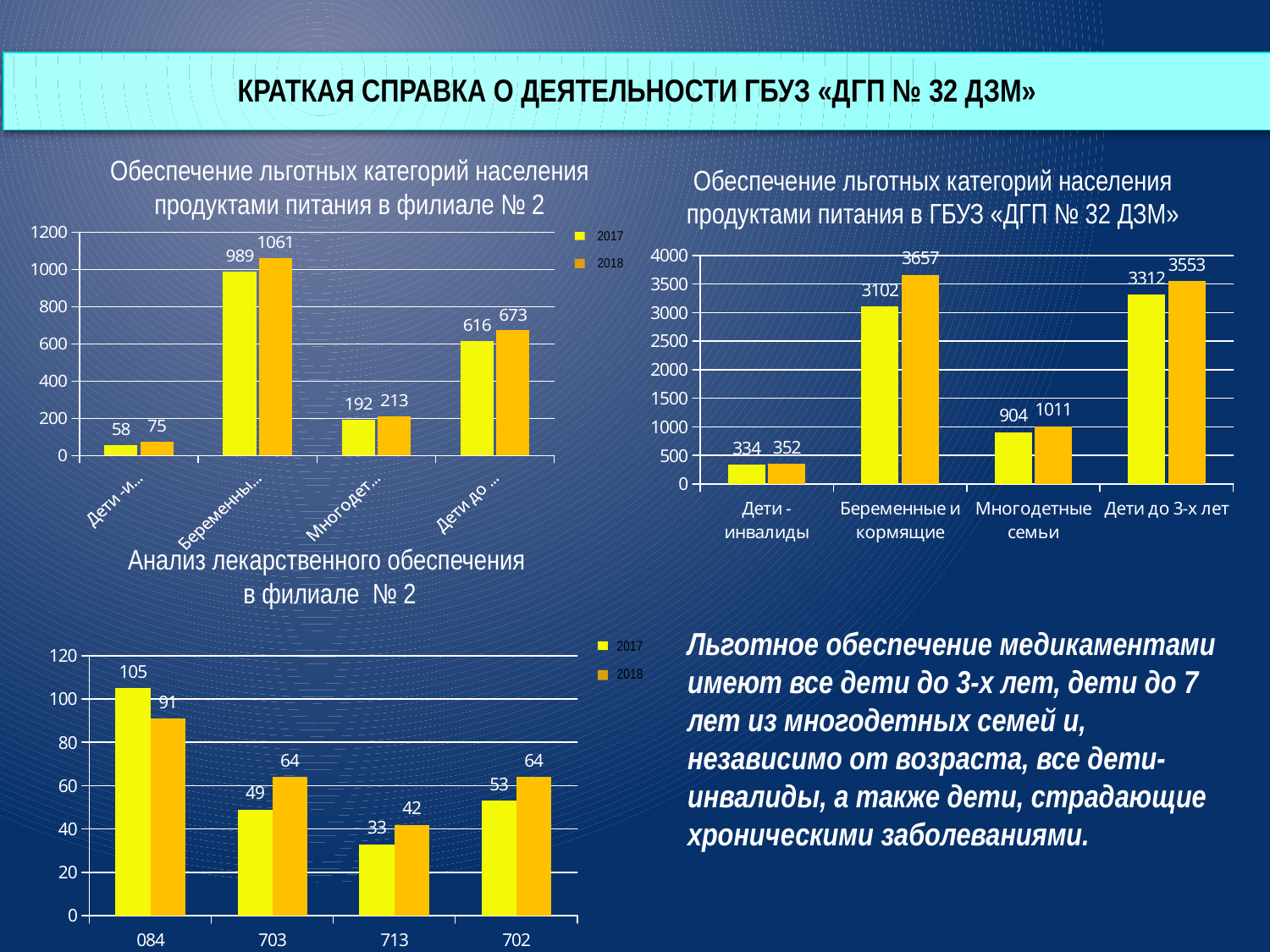
In the top-left chart 'Обеспечение льготных категорий населения продуктами питания в филиале № 2', how many categories are shown on the x axis? 4 In the top-right chart 'Обеспечение льготных категорий населения продуктами питания в ГБУЗ «ДГП № 32 ДЗМ»', what is the value of the orange bar for 'Беременные и кормящие'? 3657 In the top-right chart 'Обеспечение льготных категорий населения продуктами питания в ГБУЗ «ДГП № 32 ДЗМ»', which is larger: the yellow bar for 'Дети до 3-х лет' or the yellow bar for 'Беременные и кормящие'? Дети до 3-х лет What type of chart is the top-right chart 'Обеспечение льготных категорий населения продуктами питания в ГБУЗ «ДГП № 32 ДЗМ»'? Bar chart In the top-right chart 'Обеспечение льготных категорий населения продуктами питания в ГБУЗ «ДГП № 32 ДЗМ»', what is the value of the yellow bar for 'Многодетные семьи'? 904 In the chart 'Анализ лекарственного обеспечения в филиале № 2', what is the 2017 value for category 084? 105 In the chart 'Анализ лекарственного обеспечения в филиале № 2', what is the difference between the 2017 and 2018 values for category 703? 15 In the top-left chart 'Обеспечение льготных категорий населения продуктами питания в филиале № 2', what is the 2018 value for the second category (Беременны...)? 1061 In the chart 'Анализ лекарственного обеспечения в филиале № 2', which category has the highest 2017 value? 084 In the chart 'Анализ лекарственного обеспечения в филиале № 2', how many series does the legend list? 2 In the top-left chart 'Обеспечение льготных категорий населения продуктами питания в филиале № 2', which category has the lowest 2017 value? Дети -и... In the chart 'Анализ лекарственного обеспечения в филиале № 2', what is the 2018 value for category 713? 42